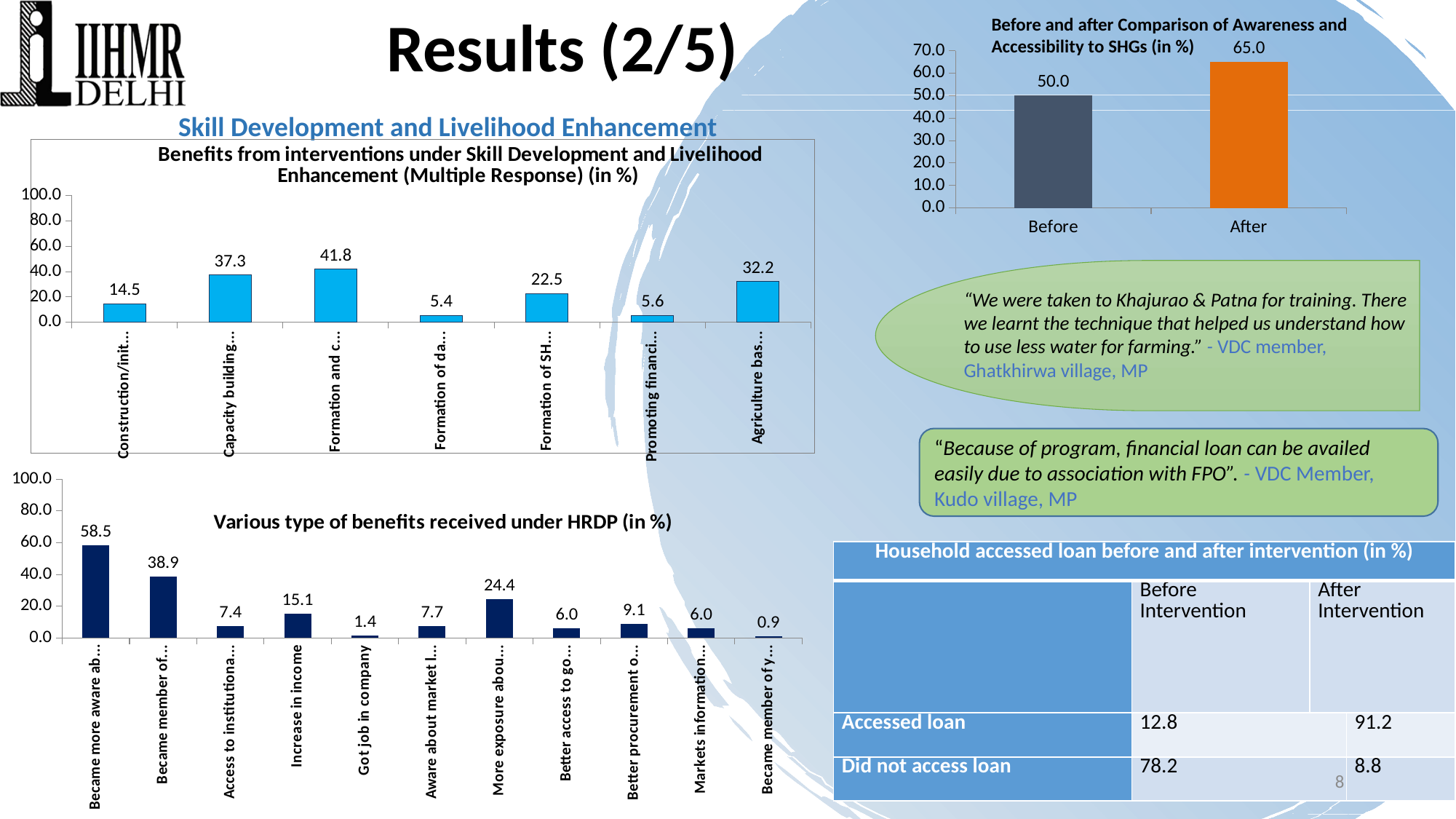
In the chart titled 'Various type of benefits received under HRDP (in %)', what is the difference between the values for 'Increase in income' and 'Got job in company'? 13.7 In the chart titled 'Before and after Comparison of Awareness and Accessibility to SHGs (in %)', what is the value for Before? 50.0 In the chart titled 'Various type of benefits received under HRDP (in %)', what is the value for 'Got job in company'? 1.4 How many bars are in the chart titled 'Various type of benefits received under HRDP (in %)'? 11 In the chart titled 'Before and after Comparison of Awareness and Accessibility to SHGs (in %)', what is the value for After? 65.0 How many bars are in the chart titled 'Benefits from interventions under Skill Development and Livelihood Enhancement (Multiple Response) (in %)'? 7 In the chart titled 'Benefits from interventions under Skill Development and Livelihood Enhancement (Multiple Response) (in %)', what is the highest value shown? 41.8 In the chart titled 'Before and after Comparison of Awareness and Accessibility to SHGs (in %)', which category is higher, Before or After? After In the chart titled 'Before and after Comparison of Awareness and Accessibility to SHGs (in %)', by how much does the After value exceed the Before value? 15.0 In the chart titled 'Various type of benefits received under HRDP (in %)', what is the value for 'Increase in income'? 15.1 In the chart titled 'Various type of benefits received under HRDP (in %)', what is the highest value shown? 58.5 What kind of chart is the one titled 'Before and after Comparison of Awareness and Accessibility to SHGs (in %)'? Bar chart